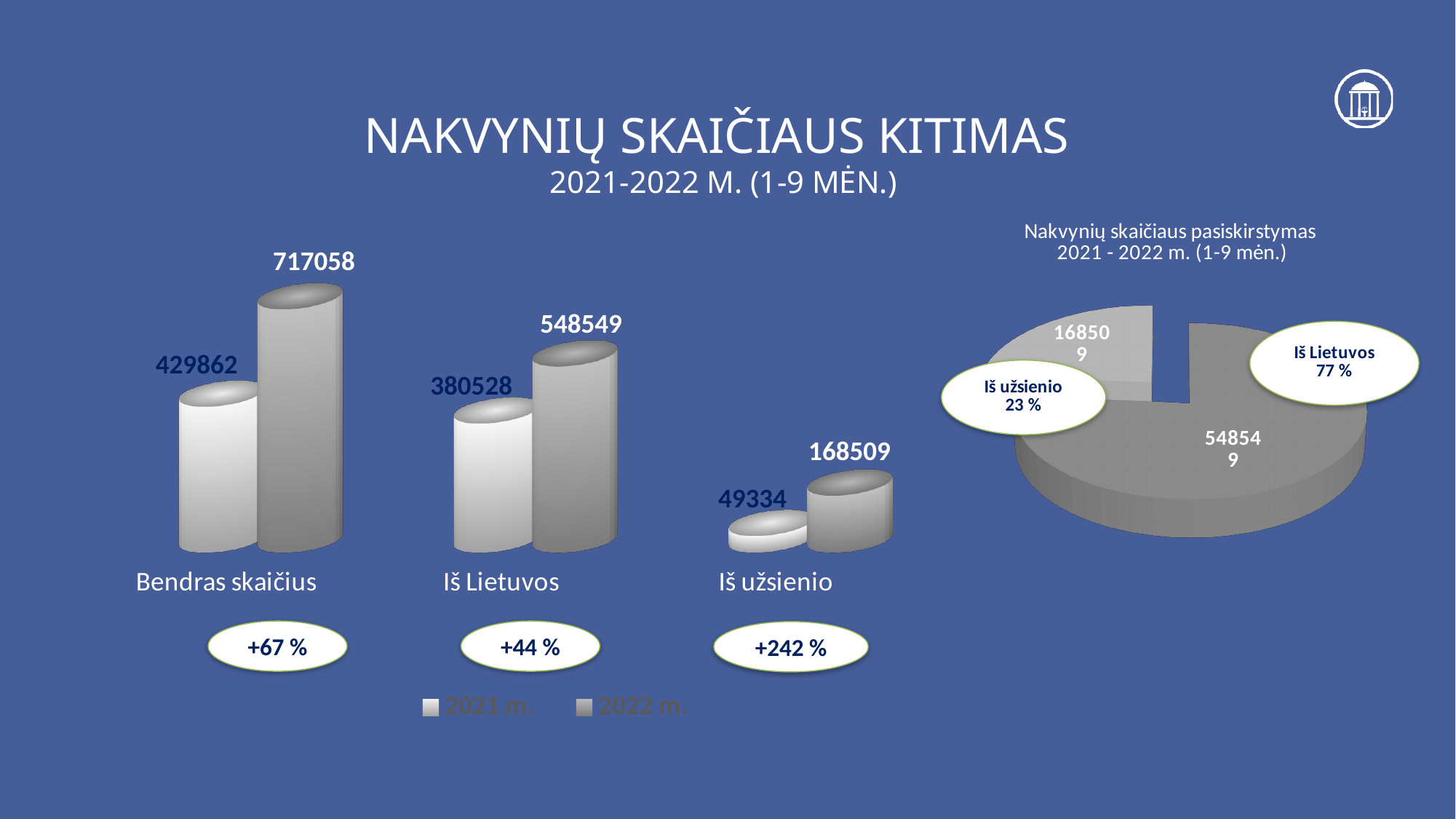
In the bar chart on the left, what is the value for Bendras skaičius in 2022 m.? 717058 In the bar chart on the left, what is the difference between the 2022 m. and 2021 m. values for Bendras skaičius? 287196 In the bar chart on the left, which category has the highest value for 2021 m.? Bendras skaičius How many categories are shown in the bar chart on the left? 3 What kind of chart is the chart on the right of the slide? Pie chart In the bar chart on the left, what is the value for Iš užsienio in 2021 m.? 49334 In the pie chart on the right, what is the value shown for the Iš užsienio slice? 168509 In the bar chart on the left, what is the value for Iš Lietuvos in 2021 m.? 380528 How many series does the legend of the bar chart on the left list? 2 In the pie chart on the right, what share does Iš Lietuvos have? 77 % In the bar chart on the left, which is larger: Iš Lietuvos in 2022 m. or Bendras skaičius in 2021 m.? Iš Lietuvos in 2022 m. In the bar chart on the left, which category has the lowest value for 2022 m.? Iš užsienio